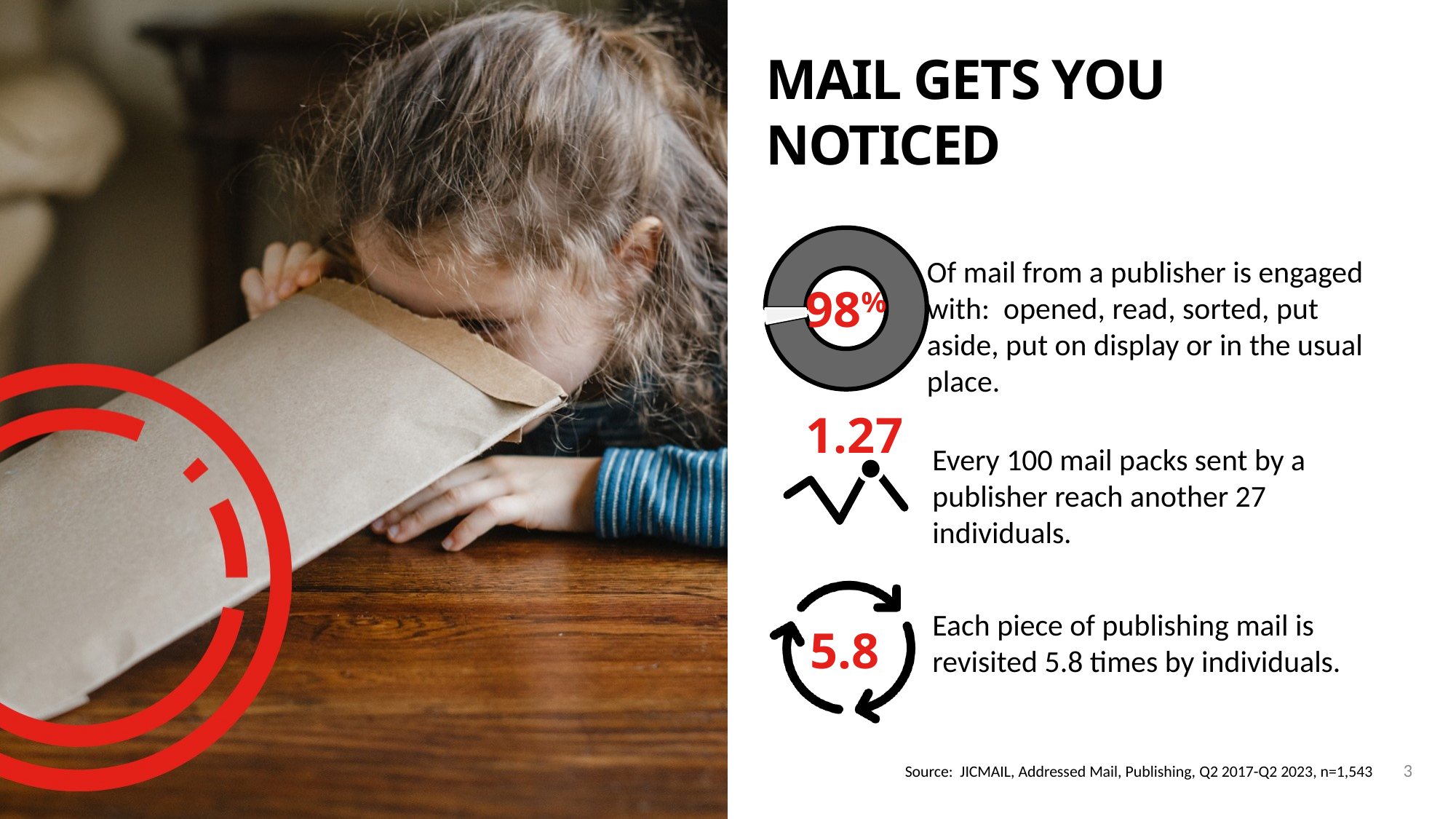
What kind of chart is shown next to the text about mail from a publisher being engaged with? pie chart (donut) Which slice of the donut chart is larger, the grey slice or the white slice? the grey slice According to the donut chart, what share of mail from a publisher is engaged with? 98% How many slices does the donut chart have? 2 What colour is the 98% label in the donut chart? red What percentage is printed in the centre of the donut chart? 98% Is the value shown in the donut chart greater or less than 90%? greater What colour is the large slice of the donut chart? grey